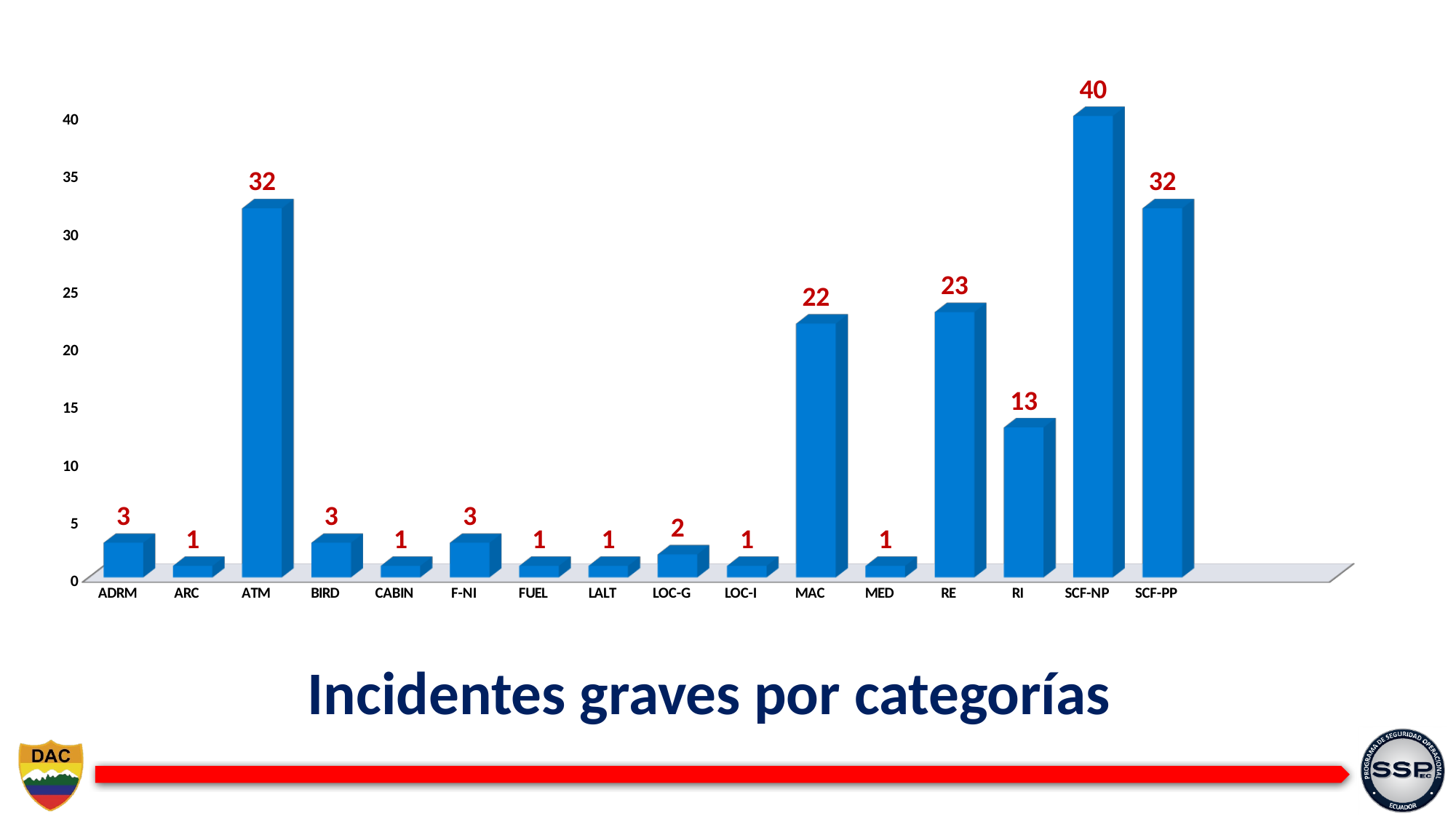
How many categories are shown on the x axis? 16 Which is larger, the value for RE or the value for RI? RE Which category has the highest value? SCF-NP What is the title of the chart? Incidentes graves por categorías What is the value for MAC? 22 What is the difference between the values for ATM and MAC? 10 What is the difference between the values for SCF-NP and RE? 17 What is the value for LOC-G? 2 What is the value for RI? 13 What kind of chart is shown on the slide? bar chart What is the value for SCF-NP? 40 Is the value for RE greater or less than 20? greater